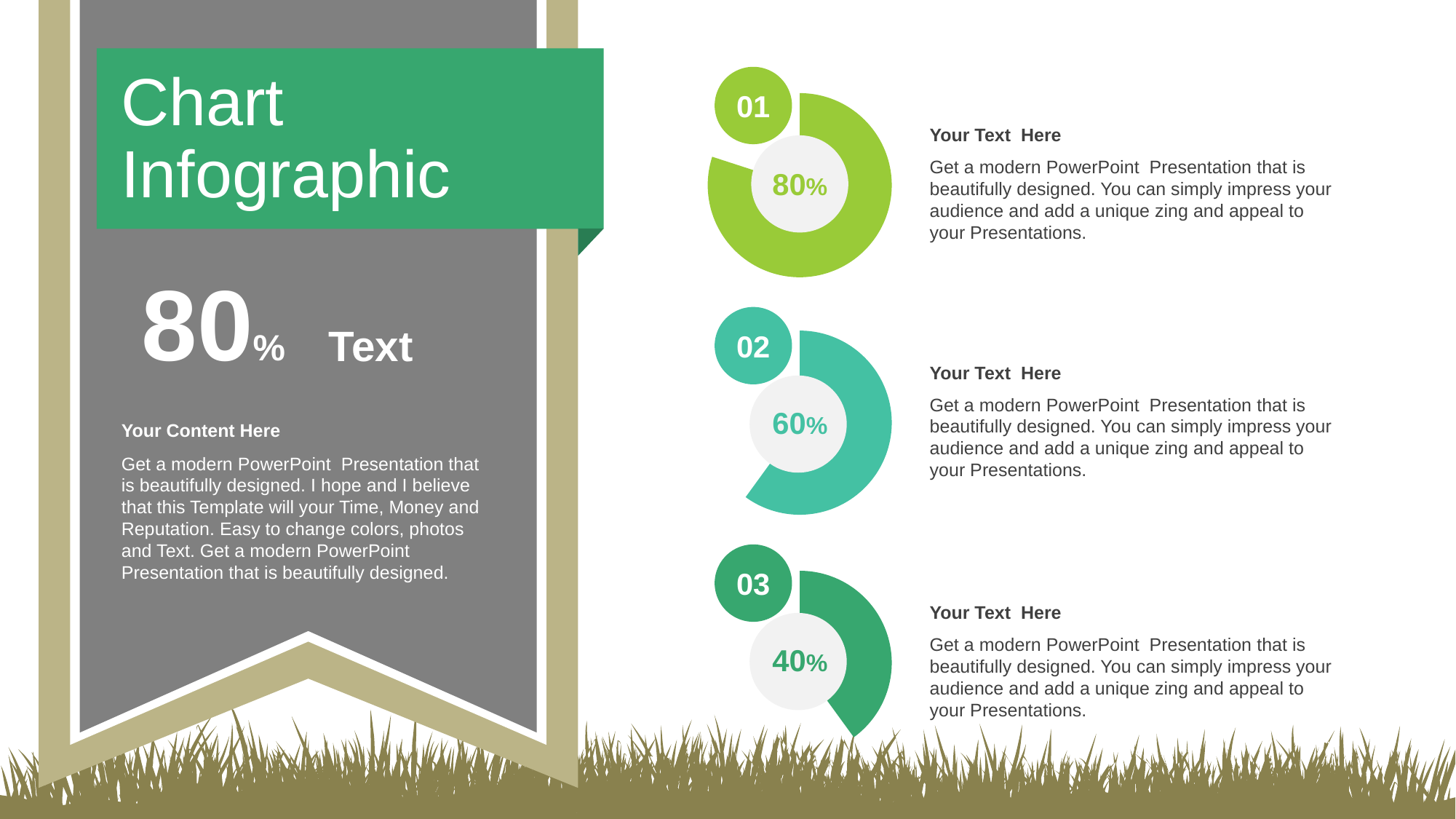
What value is shown in the centre of the chart labelled 02? 60% Which shows a larger percentage, chart 02 or chart 03? 02 What kind of chart is used for the 01, 02 and 03 items? Doughnut (ring) chart What is the difference between the percentage in chart 01 and the percentage in chart 03? 40% What is the difference between the percentage in chart 01 and the percentage in chart 02? 20% What colour is the ring of the chart labelled 01? Light green Which of the three numbered charts shows the lowest percentage? 03 What value is shown in the centre of the chart labelled 03? 40% Do the percentages rise or fall going from chart 01 at the top to chart 03 at the bottom? Fall What value is shown in the centre of the chart labelled 01? 80% How many ring charts are shown on the right side of the slide? 3 Which of the three numbered charts shows the highest percentage? 01